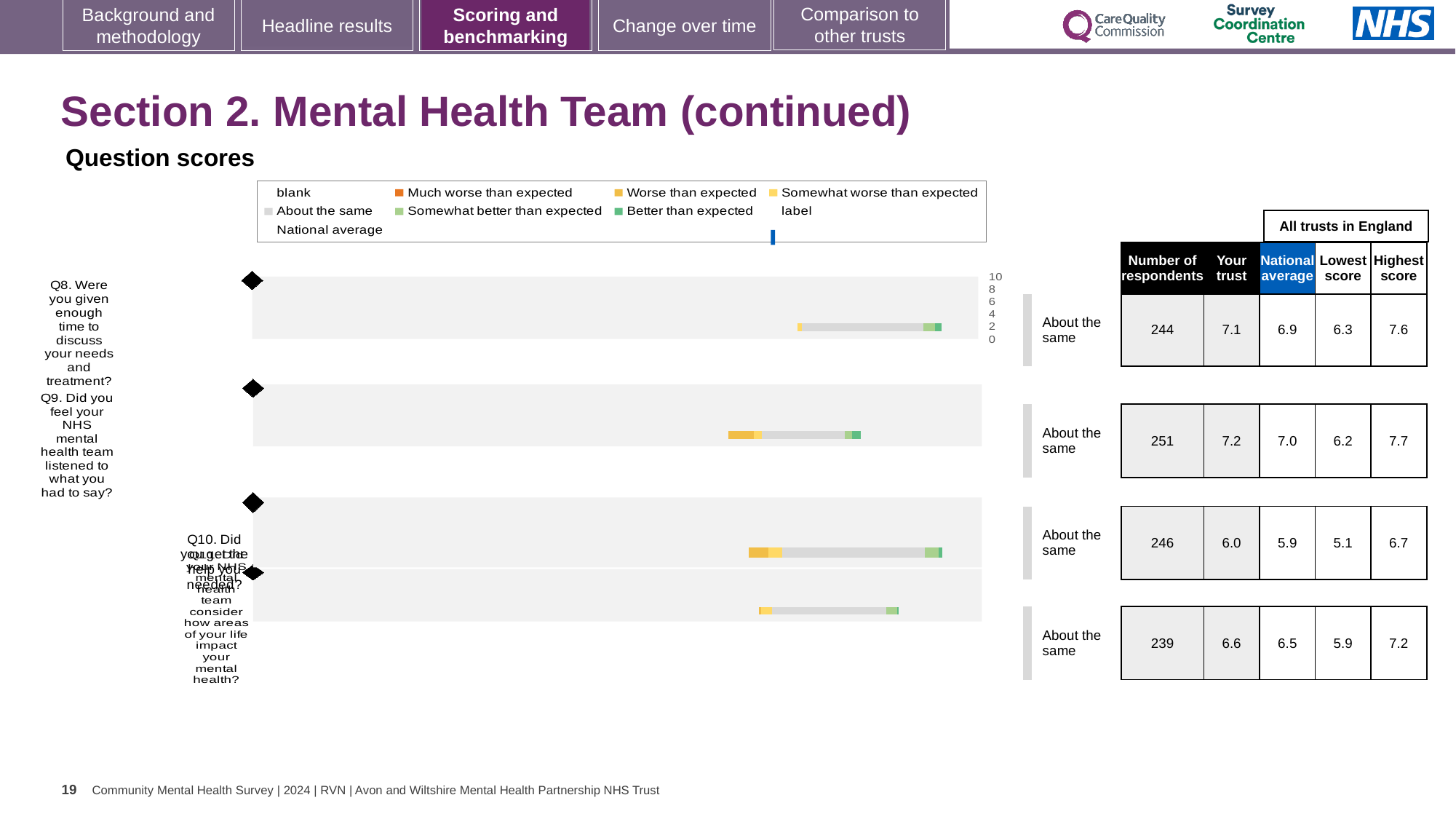
What kind of chart is used to show the question scores on this slide? bar chart According to the table beside the chart, what is the 'Your trust' score for Q8 (Were you given enough time to discuss your needs and treatment?)? 7.1 Which question has the lowest 'Your trust' score in the table beside the chart? Q10 According to the table beside the chart, what is the highest score among all trusts in England for Q11? 7.2 According to the table beside the chart, how many respondents answered Q10 (Did you get the help you needed?)? 246 According to the table beside the chart, what is the national average for Q9 (Did you feel your NHS mental health team listened to what you had to say?)? 7.0 What benchmark category is shown next to each of the four question bars? About the same What is the highest value shown on the chart's numeric axis? 10 Is the 'Your trust' score for Q9 larger or smaller than the 'Your trust' score for Q10? larger What is the difference between the 'Your trust' score and the national average for Q8? 0.2 Which question has the highest 'Your trust' score in the table beside the chart? Q9 How many questions (bars) are plotted in the question scores chart? 4